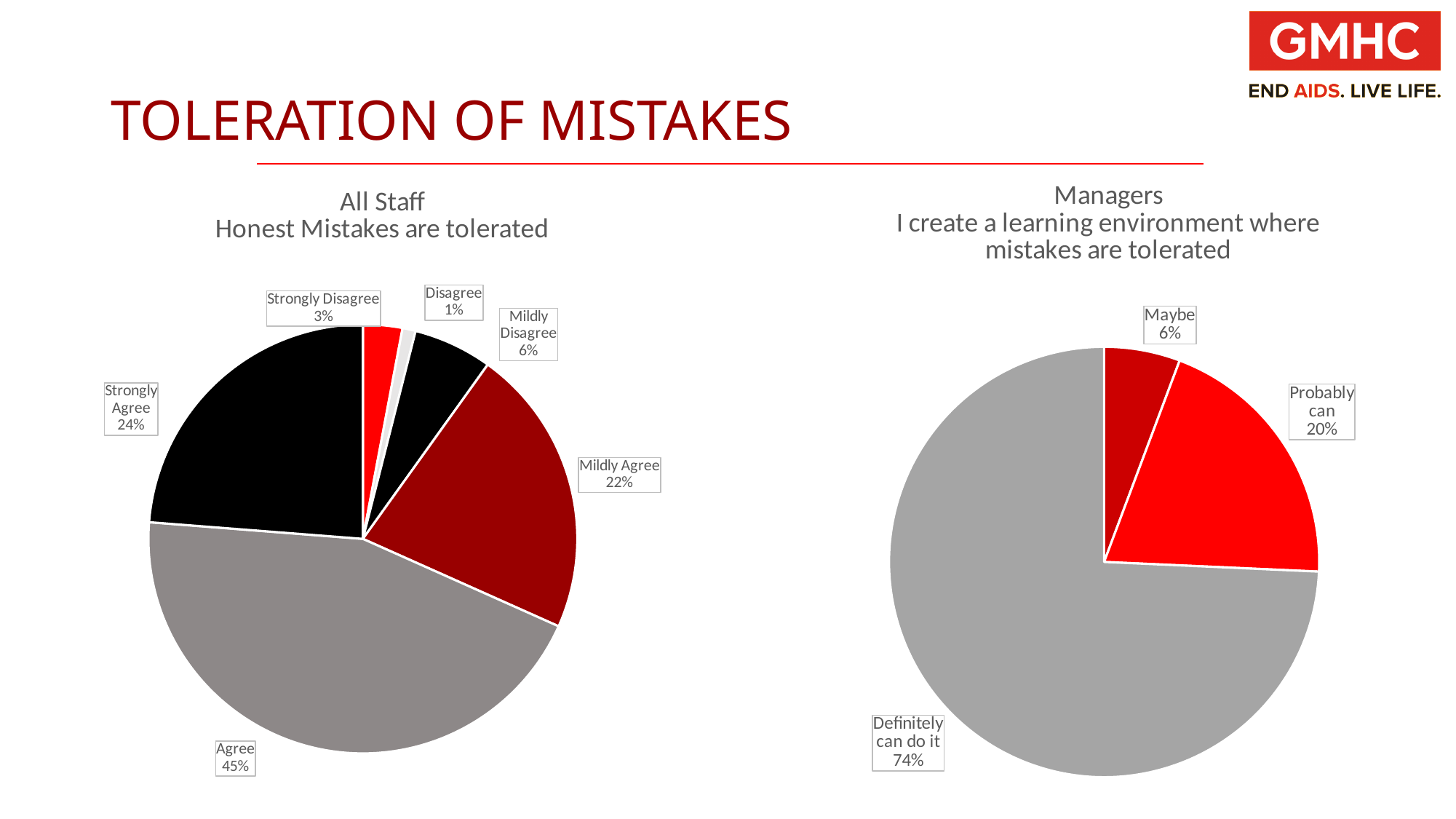
In the 'All Staff' chart, what is the difference between the 'Agree' and 'Strongly Agree' percentages? 21% In the 'All Staff' chart, what percentage chose 'Strongly Disagree'? 3% In the 'All Staff' chart, which is larger: 'Mildly Agree' or 'Strongly Agree'? Strongly Agree In the 'All Staff' chart, what percentage of respondents chose 'Agree'? 45% How many categories are shown in the 'All Staff' chart? 6 In the 'All Staff' chart, which category has the smallest share? Disagree How many categories are shown in the 'Managers' chart? 3 In the 'Managers' chart, which category has the largest share? Definitely can do it What type of chart is used for the 'Managers' data? Pie chart In the 'Managers' chart, what is the difference between 'Definitely can do it' and 'Probably can'? 54% In the 'All Staff' chart, which category has the largest share? Agree In the 'Managers' chart, what percentage chose 'Probably can'? 20%